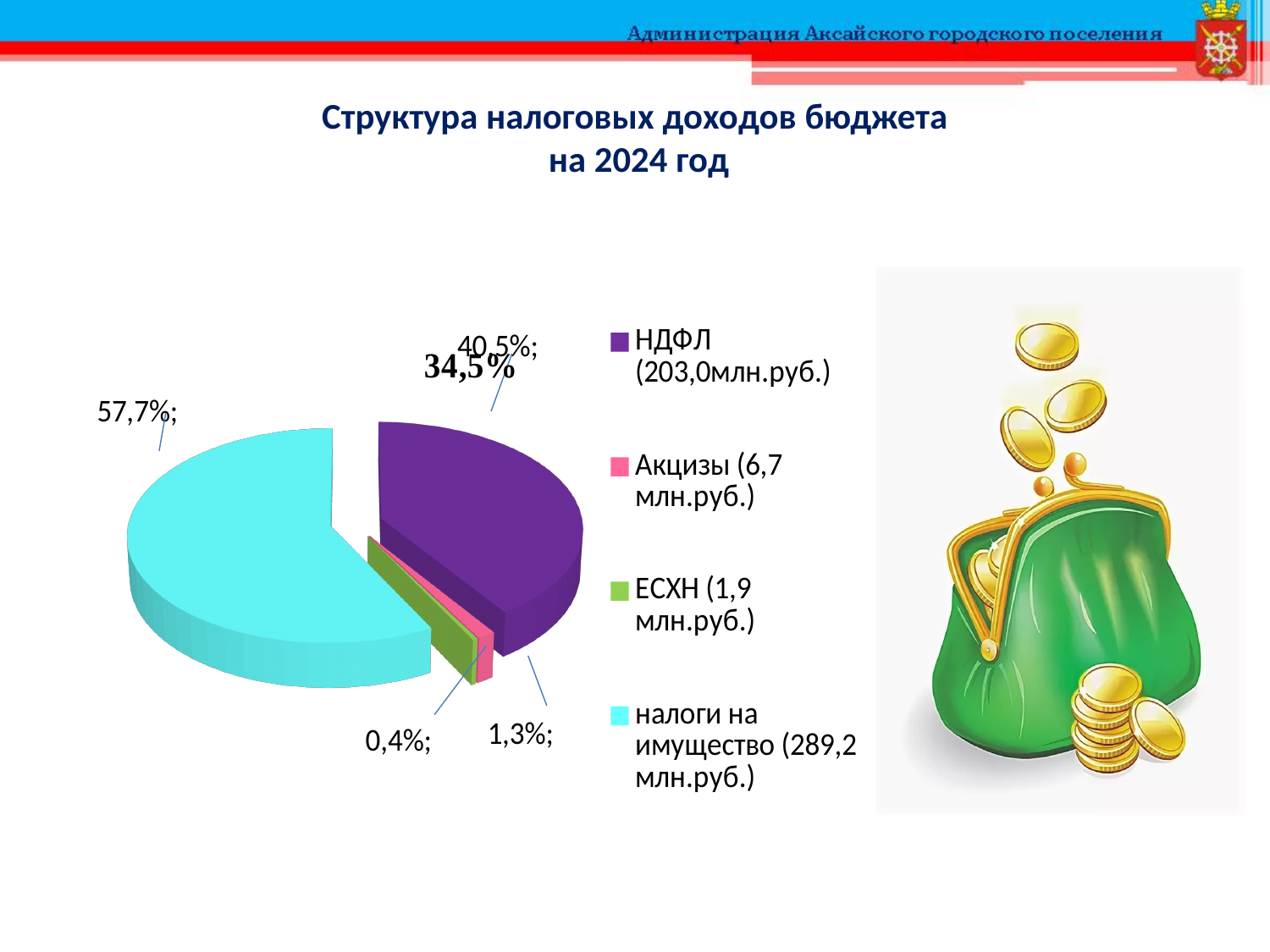
Which category has the smallest slice of the pie? ЕСХН How many entries does the legend of the pie chart list? 4 According to the legend, what amount in млн.руб. is given for налоги на имущество? 289,2 млн.руб. Which slice is larger, Акцизы or ЕСХН? Акцизы What share of the pie does ЕСХН have? 0,4% What share of the pie does налоги на имущество have? 57,7% Which category has the largest slice of the pie? налоги на имущество How many slices does the pie chart have? 4 What kind of chart is shown on the slide? pie chart What is the difference in percentage points between the Акцизы slice and the ЕСХН slice? 0,9% What colour is the НДФЛ slice in the pie chart? purple What share of the pie does Акцизы have? 1,3%